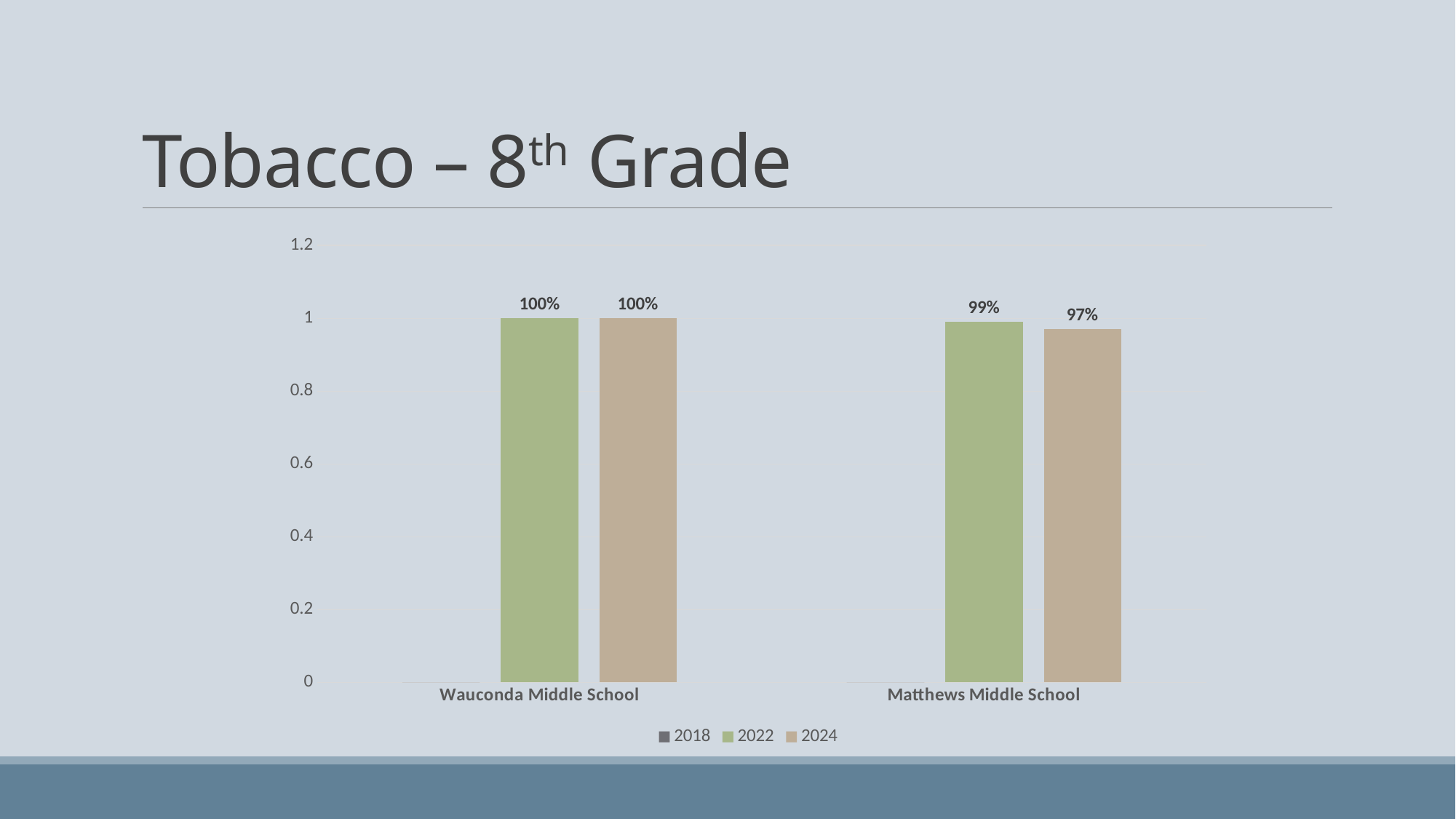
What is the 2022 value for Wauconda Middle School? 100% Which school has the lowest 2024 value? Matthews Middle School What is the 2024 value for Matthews Middle School? 97% What is the 2024 value for Wauconda Middle School? 100% What kind of chart is shown on the slide? Bar chart What is the title of the slide? Tobacco – 8th Grade How many schools are shown on the x axis? 2 Which years are listed in the legend? 2018, 2022, 2024 What is the 2022 value for Matthews Middle School? 99% What is the difference between the 2022 and 2024 values for Matthews Middle School? 2% How many series does the legend list? 3 Which is larger, the 2022 value for Wauconda Middle School or the 2022 value for Matthews Middle School? Wauconda Middle School